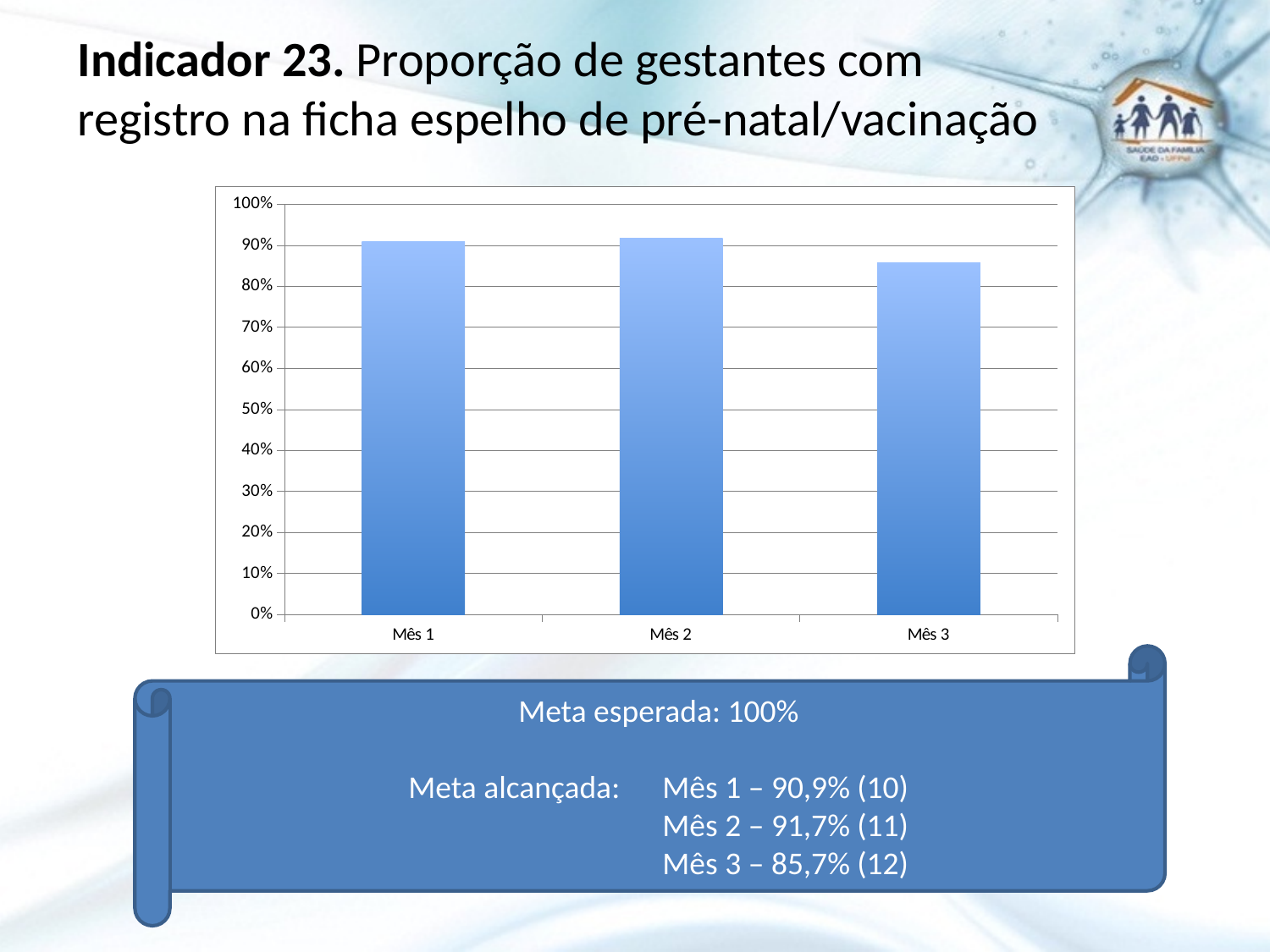
According to the slide, what proportion was achieved in Mês 2? 91,7% According to the slide, what proportion was achieved in Mês 1? 90,9% According to the slide, what proportion was achieved in Mês 3? 85,7% Is the value for Mês 2 greater or less than 90%? greater What is the expected target (meta esperada) stated on the slide? 100% How many categories (months) are plotted on the chart? 3 Which month has the lowest bar on the chart? Mês 3 Which is larger, the value for Mês 1 or the value for Mês 3? Mês 1 Is the value for Mês 3 greater or less than 90%? less Is the value for Mês 1 greater or less than 80%? greater What is the difference between the values for Mês 1 and Mês 3 as stated on the slide? 5,2 percentage points What kind of chart is shown on the slide? bar chart